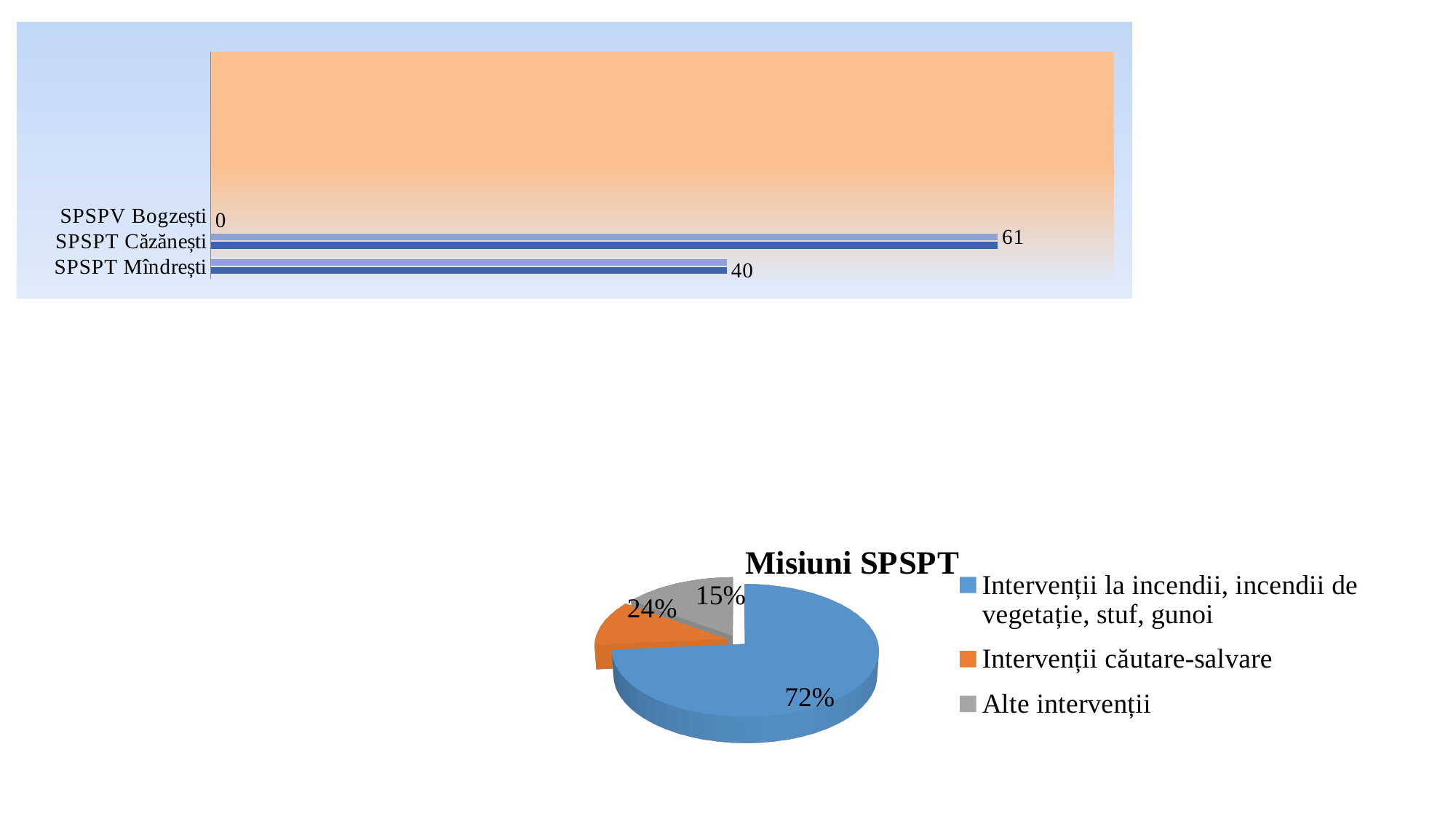
What kind of chart is the top chart on the slide? bar chart In the top bar chart, what is the value for SPSPV Bogzești? 0 In the Misiuni SPSPT pie chart, what share is labelled for Intervenții căutare-salvare? 24% In the top bar chart, what is the value for SPSPT Căzănești? 61 In the Misiuni SPSPT pie chart, what share is labelled for Intervenții la incendii, incendii de vegetație, stuf, gunoi? 72% How many entries does the legend of the Misiuni SPSPT pie chart list? 3 In the top bar chart, what is the difference between the values for SPSPT Căzănești and SPSPT Mîndrești? 21 In the top bar chart, which category has the highest value? SPSPT Căzănești In the top bar chart, how many categories are shown? 3 In the top bar chart, what is the value for SPSPT Mîndrești? 40 In the top bar chart, which category has the lowest value? SPSPV Bogzești